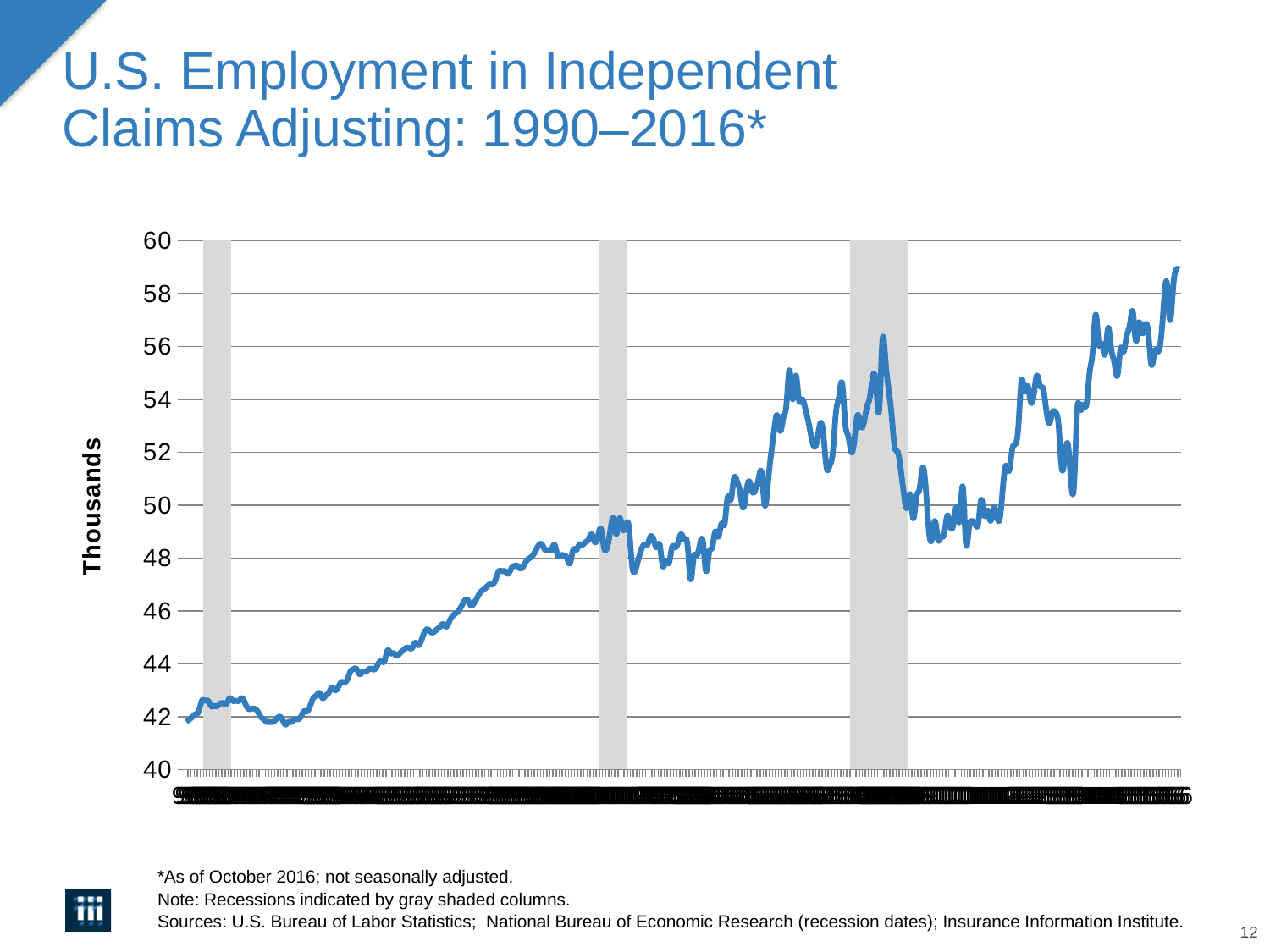
Is the highest point reached by the line greater or less than 58? greater Is the value at the end of the series (right end of the line) greater or less than 58? greater How many data series are plotted on the chart? 1 Is the lowest point of the line greater or less than 44? less What kind of chart is shown on the slide? line chart Is the value at the right end of the line greater or less than the value at the left end of the line? greater What is the highest value shown on the vertical axis of the chart? 60 What is the label on the vertical axis of the chart? Thousands Overall, does the line rise or fall from the left of the chart to the right? rise How many gray shaded recession columns are shown on the chart? 3 What is the title of the chart on the slide? U.S. Employment in Independent Claims Adjusting: 1990–2016*